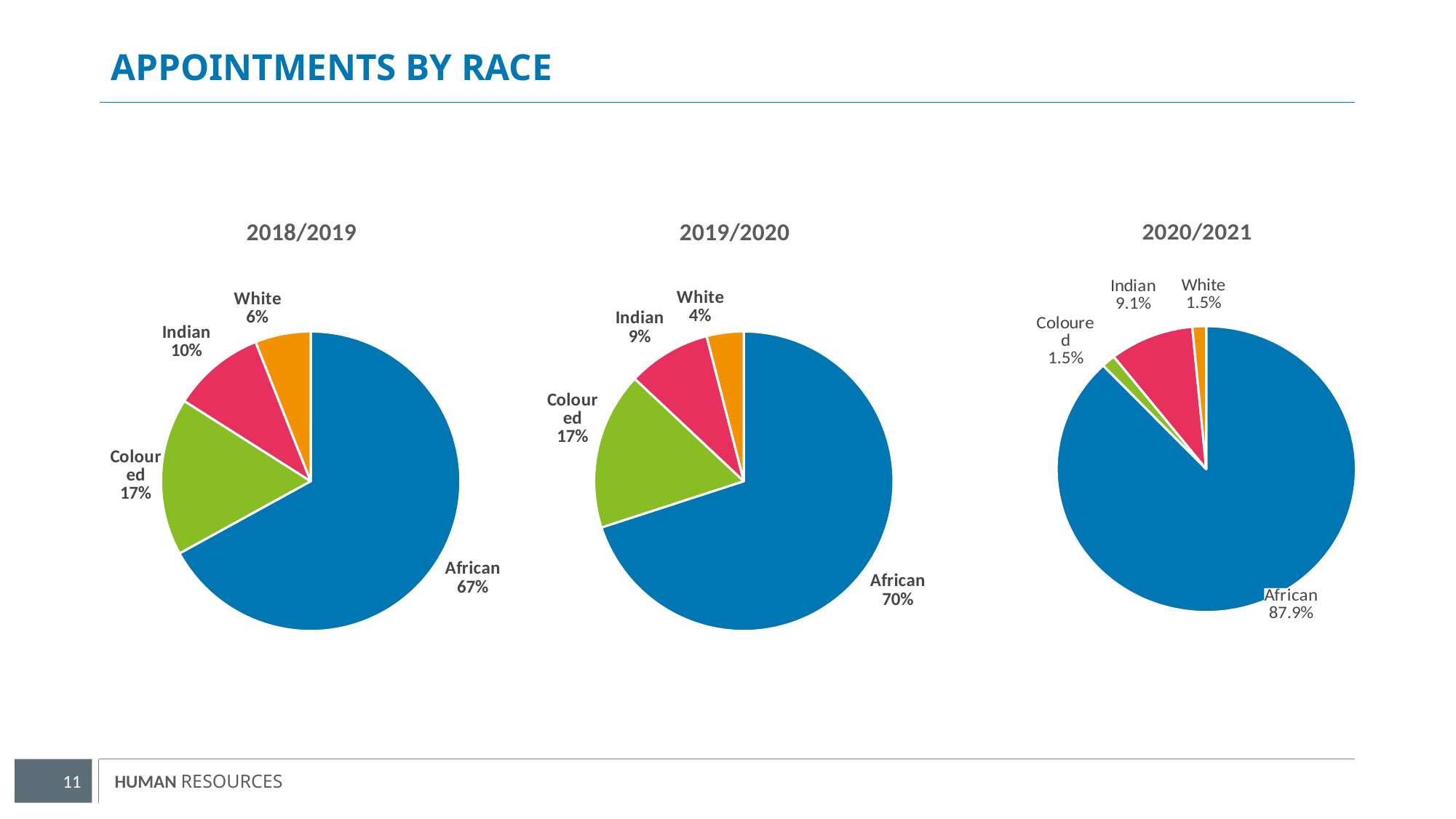
How many pie charts are shown on the slide? 3 How many slices does the 2020/2021 pie chart have? 4 In the 2019/2020 chart, which race has the largest share? African In the 2020/2021 chart, what share of appointments is Indian? 9.1% In the 2020/2021 chart, what is the difference between the African and Indian shares? 78.8% In the 2019/2020 chart, which is larger, the Indian share or the White share? Indian In the 2018/2019 chart, which race has the smallest share? White In the 2019/2020 chart, what share of appointments is Coloured? 17% In the 2020/2021 chart, what share of appointments is African? 87.9% In the 2018/2019 chart, what share of appointments is African? 67% In the 2018/2019 chart, what is the difference between the Coloured and Indian shares? 7% What kind of chart is used for 2018/2019? Pie chart